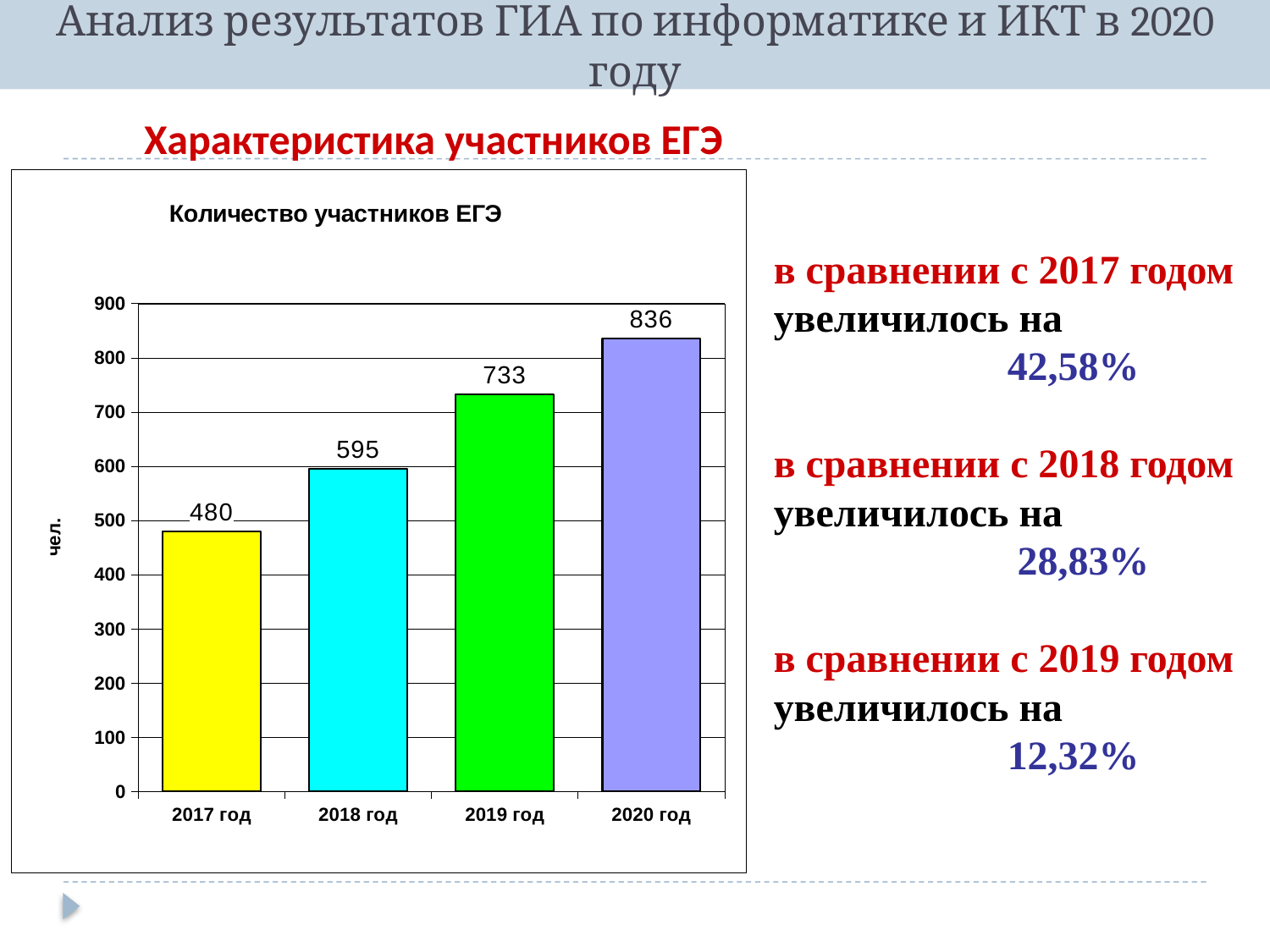
What is the difference in the number of participants between 2020 год and 2019 год? 103 What is the number of EGE participants in 2018 год? 595 Which year has the highest number of EGE participants? 2020 год Does the number of participants rise or fall from 2017 год to 2020 год? Rise What is the number of EGE participants in 2017 год? 480 What is the number of EGE participants in 2019 год? 733 How many years are shown on the chart? 4 Which year has the lowest number of EGE participants? 2017 год Which year has more participants, 2018 год or 2019 год? 2019 год What is the number of EGE participants in 2020 год? 836 What is the difference in the number of participants between 2018 год and 2017 год? 115 What type of chart is shown on the slide? Bar chart